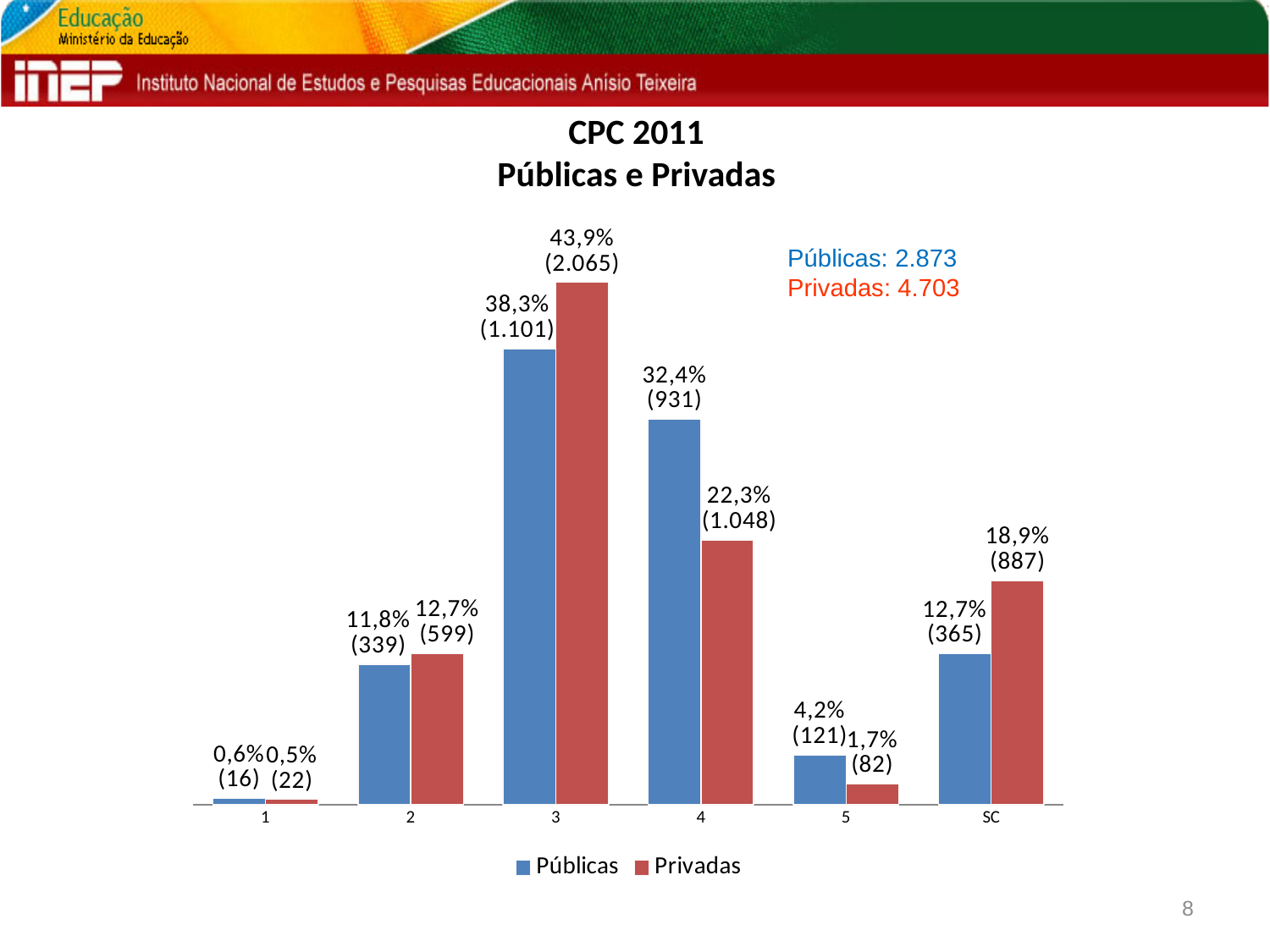
Which category has the highest percentage for Privadas? 3 How many series does the legend list? 2 In category 4, which series has the larger percentage, Públicas or Privadas? Públicas What total number is given for Privadas in the text on the slide? 4.703 What is the difference in percentage points between Privadas and Públicas in category 3? 5,6 How many categories are shown on the x axis? 6 What percentage is shown for Privadas in category SC? 18,9% What is the count shown in parentheses for Privadas in category 3? 2.065 What kind of chart is shown on the slide? Bar chart Which category has the lowest percentage for Públicas? 1 What is the count shown in parentheses for Públicas in category 5? 121 What percentage is shown for Públicas in category 3? 38,3%